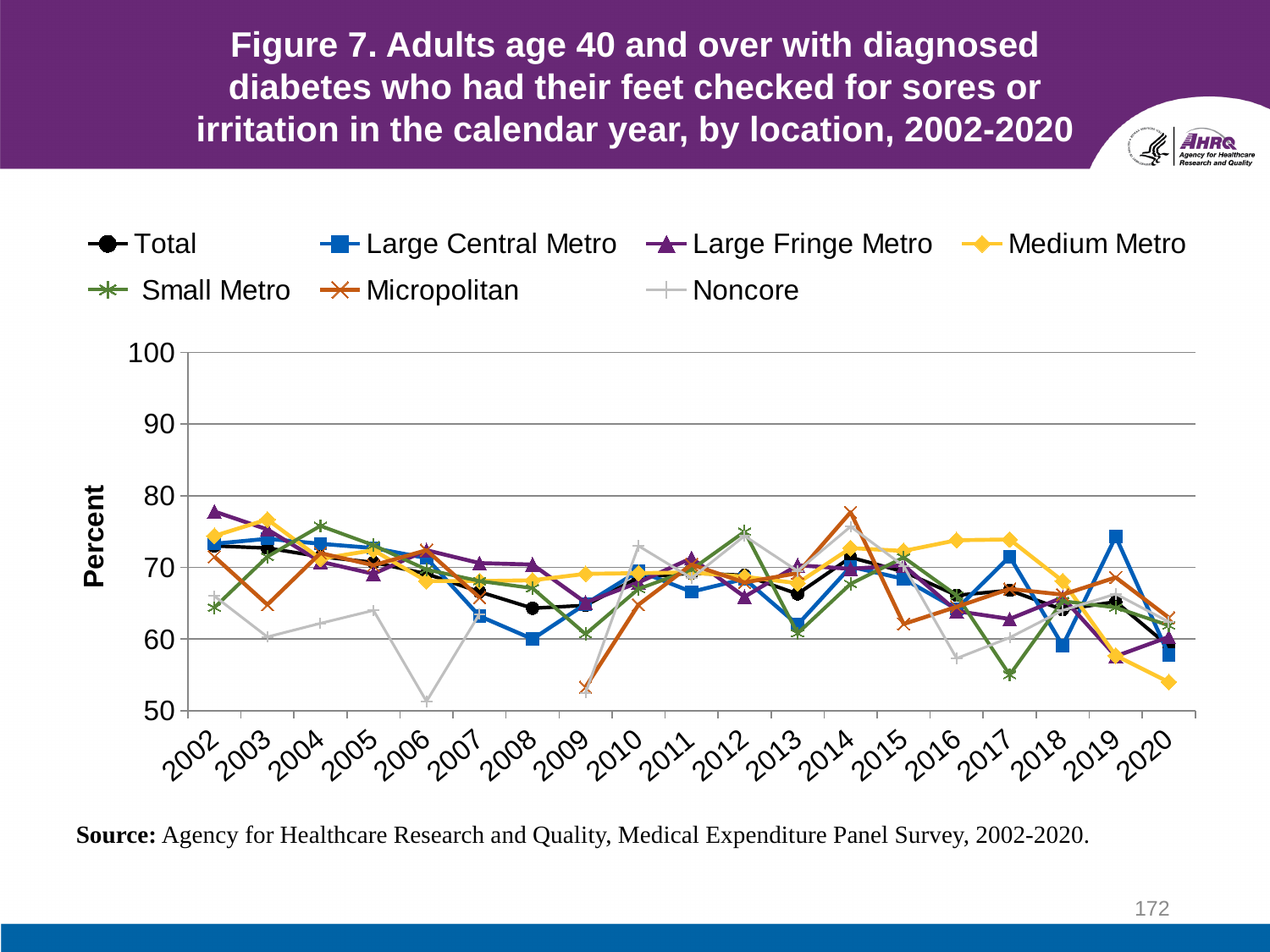
In which year does the Micropolitan series reach its highest value? 2014 How many series does the legend list? 7 Is the value for Medium Metro in 2020 greater or less than 60? less How many years are plotted along the x axis? 19 Is the value for Noncore in 2006 greater or less than 60? less Does the Total series rise or fall overall from 2002 to 2020? Fall What kind of chart is shown on the slide? Line chart Is the value for Large Fringe Metro in 2002 greater or less than 70? greater In which year does the Noncore series reach its lowest value? 2006 What is the label on the vertical axis? Percent Which years does the chart title say the data covers? 2002-2020